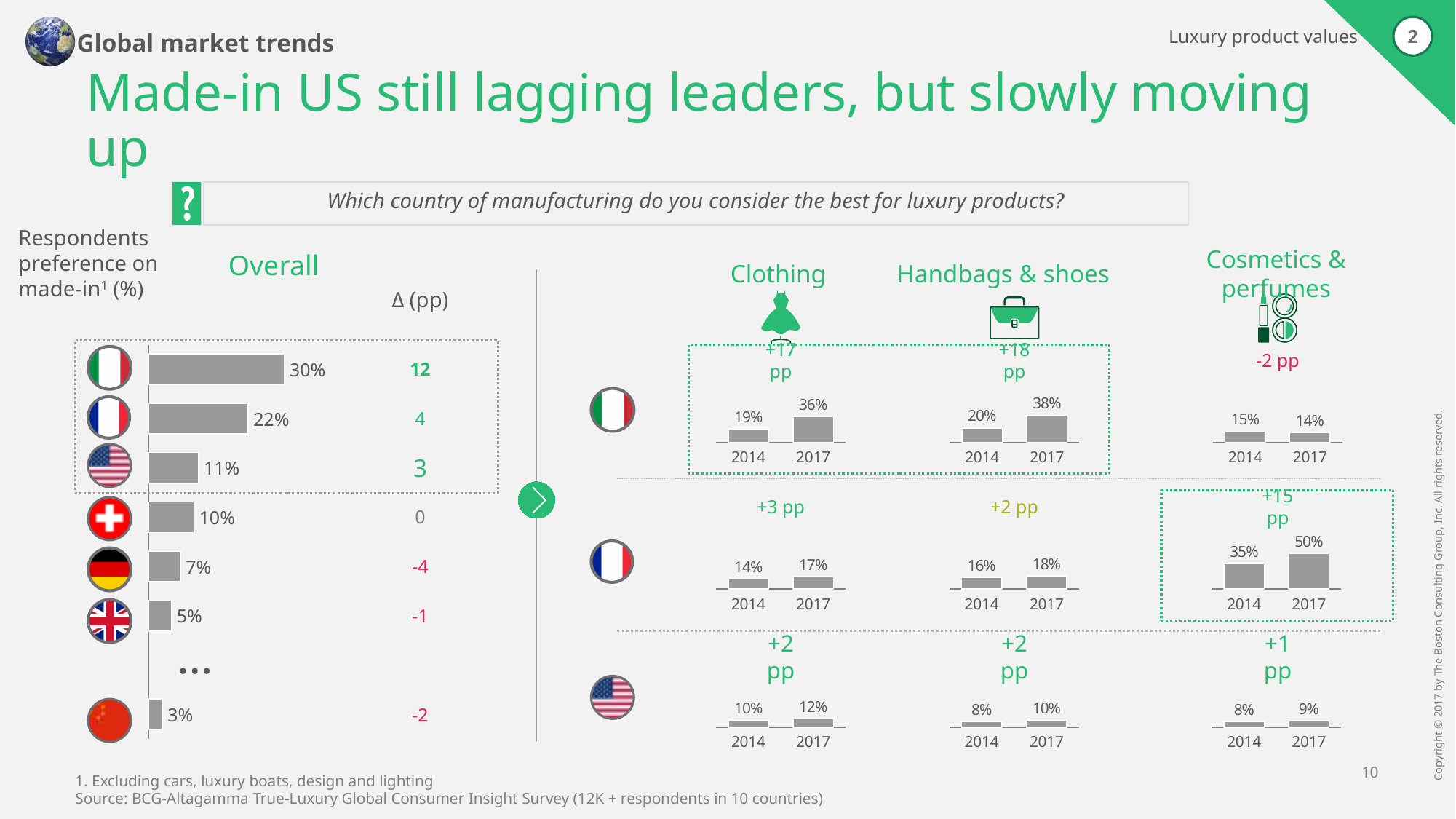
In the Handbags & shoes chart for Italy, what is the change from 2014 to 2017 shown above the bars? +18 pp In the Overall chart, what is the value for the top bar (Italy)? 30% In the Clothing chart for Italy, what is the value for 2017? 36% In the Overall chart, what is the value for the US bar? 11% In the Cosmetics & perfumes chart for Italy, do the values rise or fall from 2014 to 2017? fall In the Overall chart, which country has the highest respondent preference? Italy In the Overall chart, what is the difference between the Italy bar (30%) and the France bar (22%)? 8 percentage points In the Overall chart, how many country bars are plotted? 7 In the Overall chart, which country has the lowest value shown? China (3%) What kind of chart is used in the Overall section? bar chart In the Overall chart, what is the Δ (pp) value shown for Germany? -4 In the Cosmetics & perfumes chart for France, what is the value for 2017? 50%